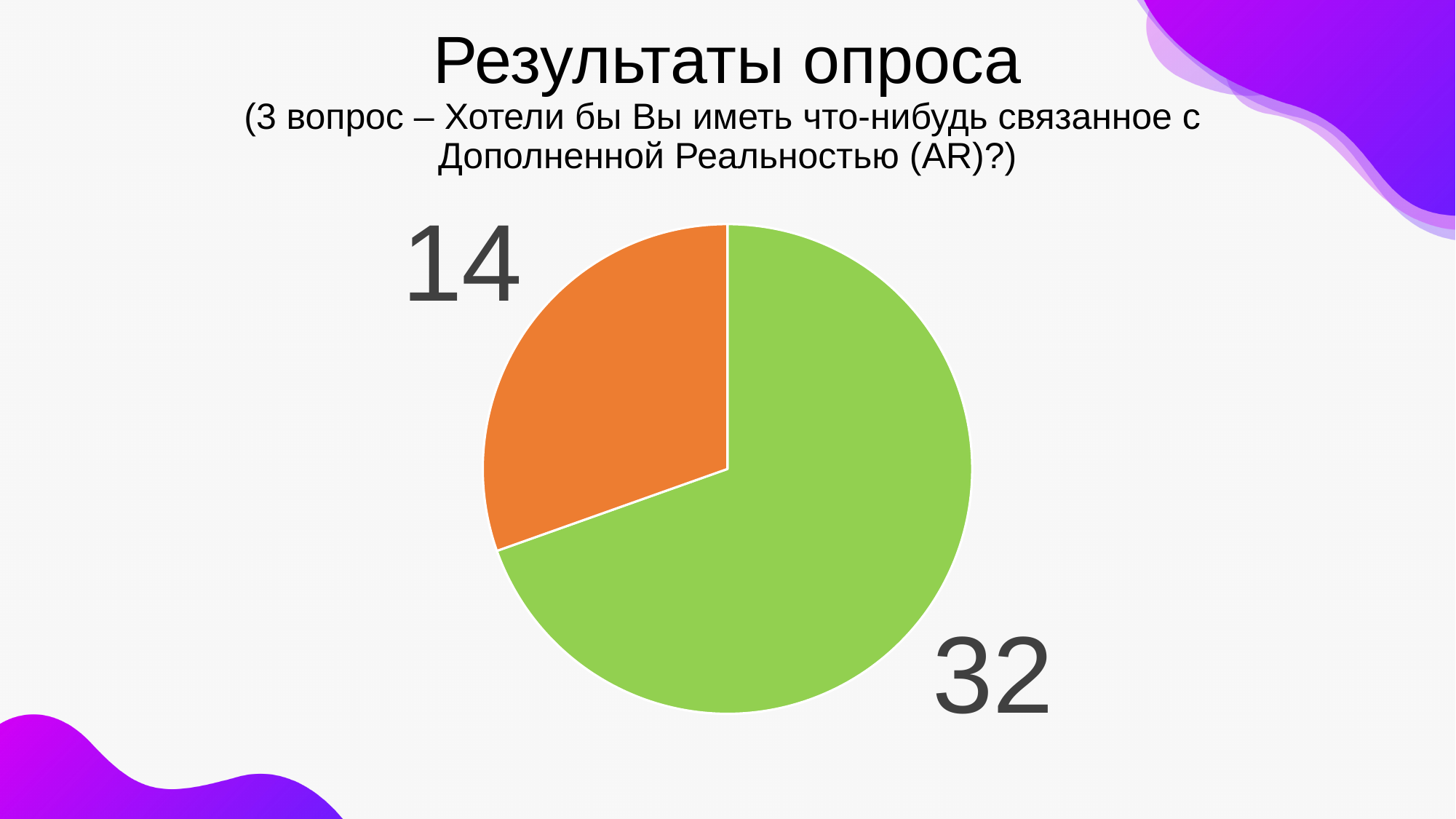
Which slice of the pie chart has the largest value? the green slice (32) Which is larger, the orange slice or the green slice? the green slice What value is shown for the green slice of the pie chart? 32 What is the total of the two values shown on the pie chart? 46 What kind of chart is shown on the slide? pie chart What colour is the slice labelled 14? orange What is the difference between the green slice value and the orange slice value? 18 How many slices does the pie chart have? 2 What value is shown for the orange slice of the pie chart? 14 Which slice of the pie chart has the smallest value? the orange slice (14) What is the main title of the slide containing the pie chart? Результаты опроса